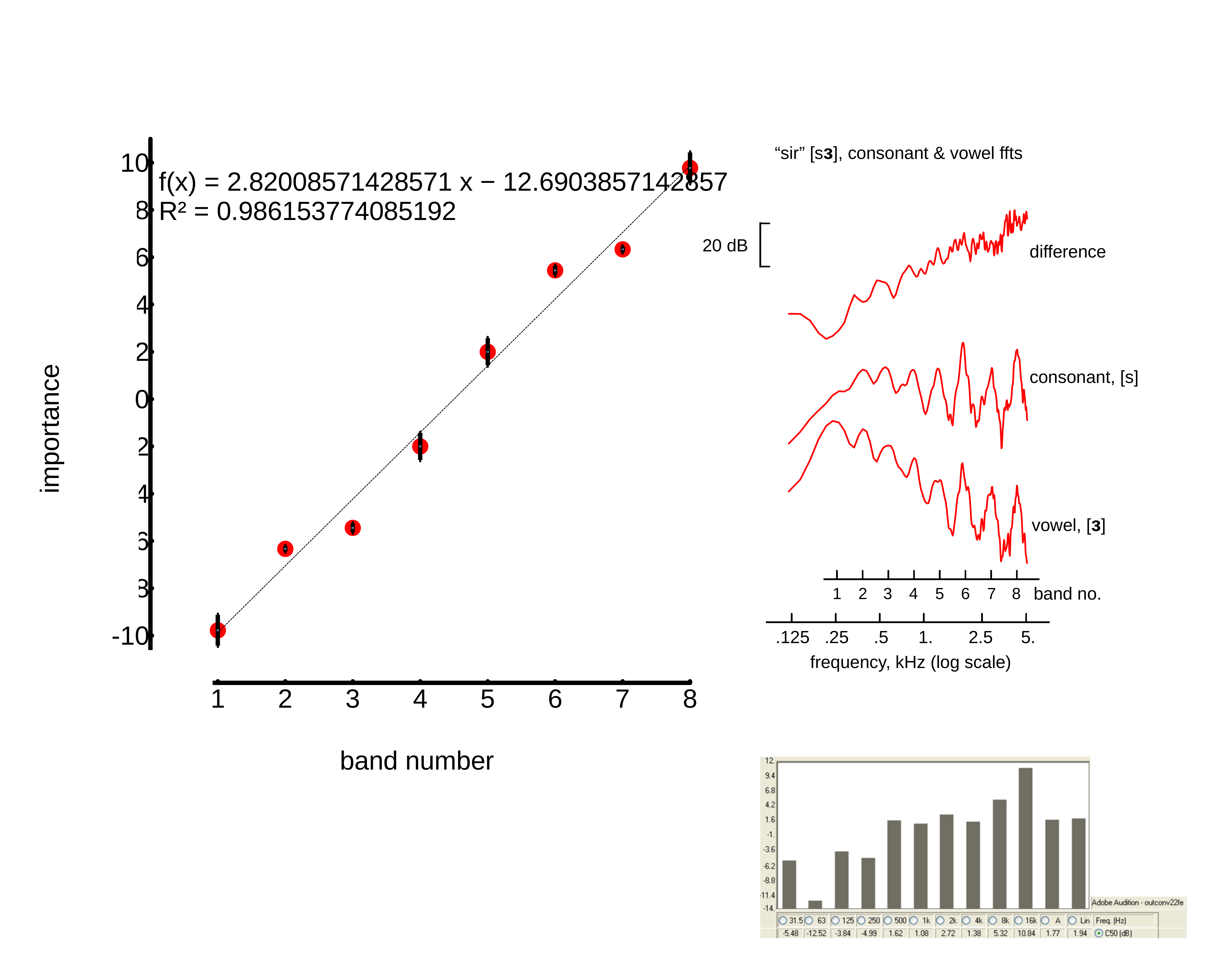
In the bar chart at the bottom right of the slide, which frequency band has the lowest value? 63 In the '"sir" [sɜ], consonant & vowel ffts' chart, how many curves are labelled? 3 In the 'importance' versus 'band number' chart, which band number has the highest importance? 8 In the bar chart at the bottom right of the slide, what is the value for the 16k band? 10.84 In the 'importance' versus 'band number' chart, is the importance for band 6 greater or less than 4? greater In the 'importance' versus 'band number' chart, do the values rise or fall as band number increases? rise In the 'importance' versus 'band number' chart, is the importance for band 3 greater or less than -4? less In the 'importance' versus 'band number' chart, how many data points are plotted? 8 What kind of chart is the 'importance' versus 'band number' chart on the left of the slide? scatter plot In the bar chart at the bottom right of the slide, what is the difference between the 16k value and the 8k value? 5.52 In the 'importance' versus 'band number' chart, which band number has the lowest importance? 1 In the 'importance' versus 'band number' chart, what R² value is printed for the fitted line? 0.986153774085192